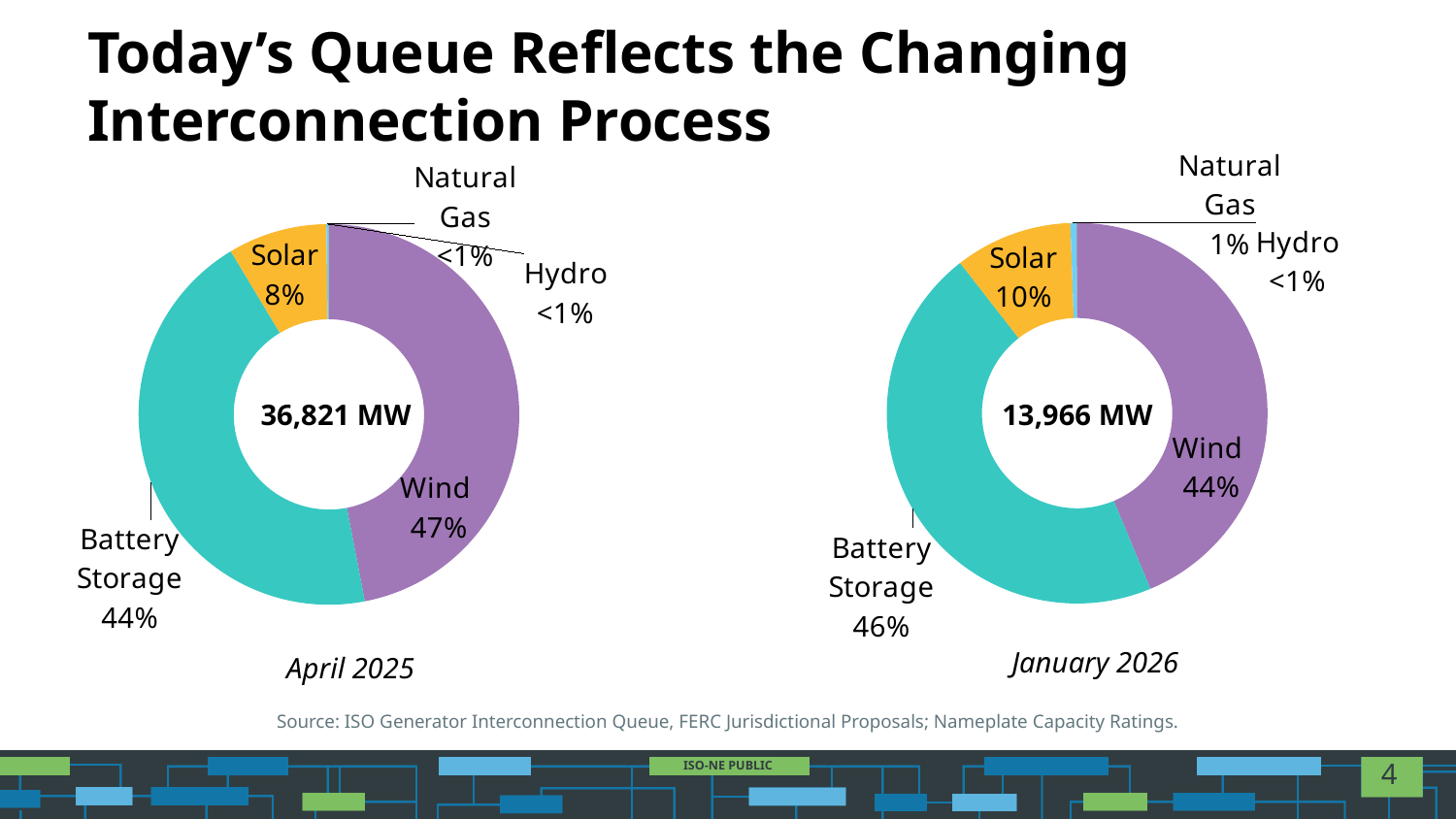
In the April 2025 chart, what share of the queue is Wind? 47% What kind of chart is used on this slide? Pie (donut) chart In the April 2025 chart, which category has the largest share? Wind In the April 2025 chart, what share of the queue is Solar? 8% In the January 2026 chart, which category has the largest share? Battery Storage In the January 2026 chart, what share of the queue is Solar? 10% In the April 2025 chart, what is the difference in percentage points between Wind and Battery Storage? 3 percentage points In the January 2026 chart, which is larger, Battery Storage or Wind? Battery Storage What total capacity is shown in the centre of the April 2025 chart? 36,821 MW What total capacity is shown in the centre of the January 2026 chart? 13,966 MW